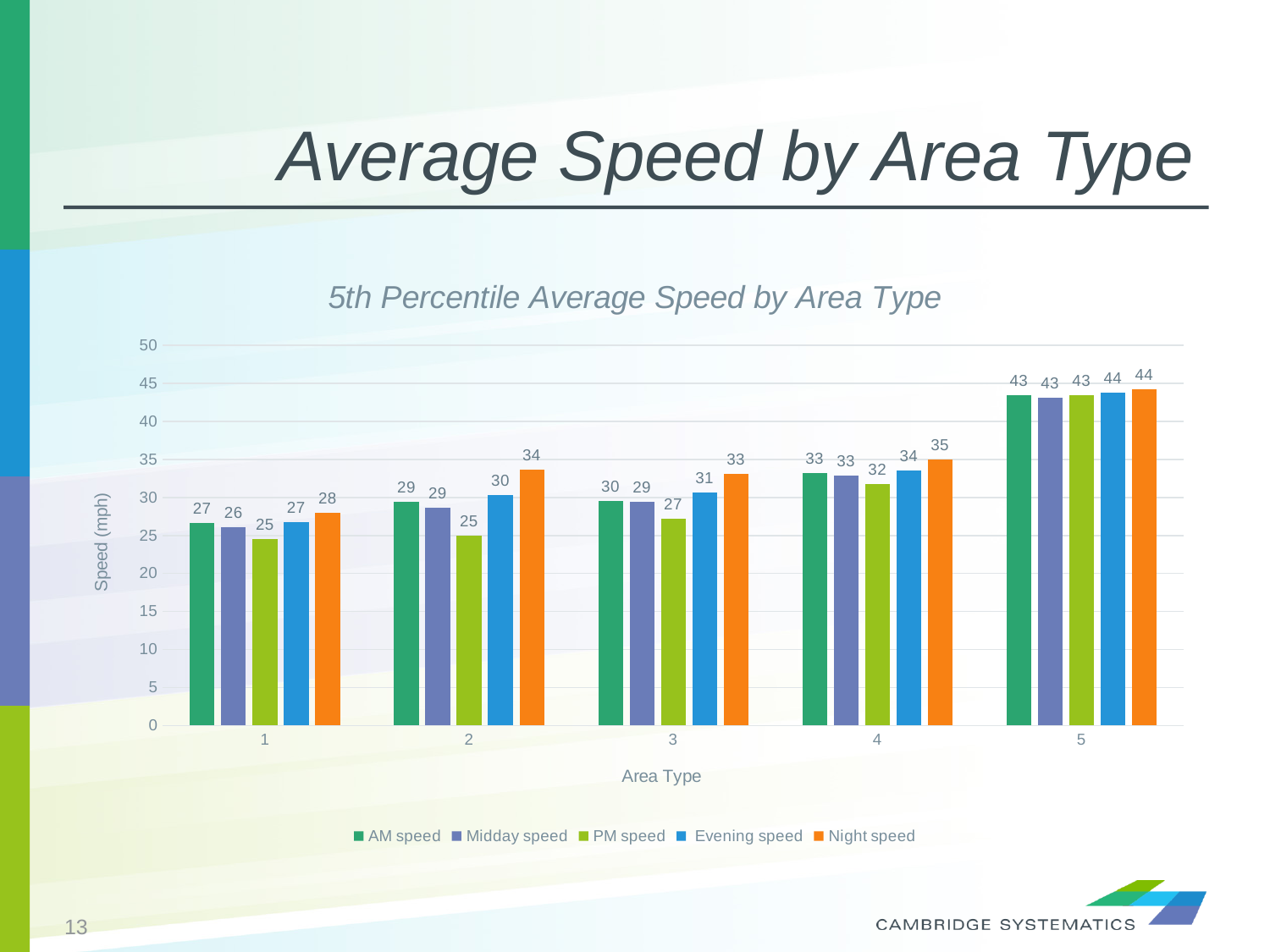
How many area types are shown on the x axis? 5 What is the PM speed for Area Type 1? 25 Which area type has the highest Night speed? 5 Which area type has the lowest PM speed? 1 and 2 (tied at 25) What is the difference between the Night speed and the PM speed for Area Type 3? 6 What is the Night speed for Area Type 2? 34 Is the Midday speed for Area Type 5 greater or less than 40? greater What is the Evening speed for Area Type 4? 34 What is the title of the chart? 5th Percentile Average Speed by Area Type Which is larger for Area Type 4: the AM speed or the PM speed? AM speed How many series does the legend list? 5 What kind of chart is shown on the slide? Bar chart